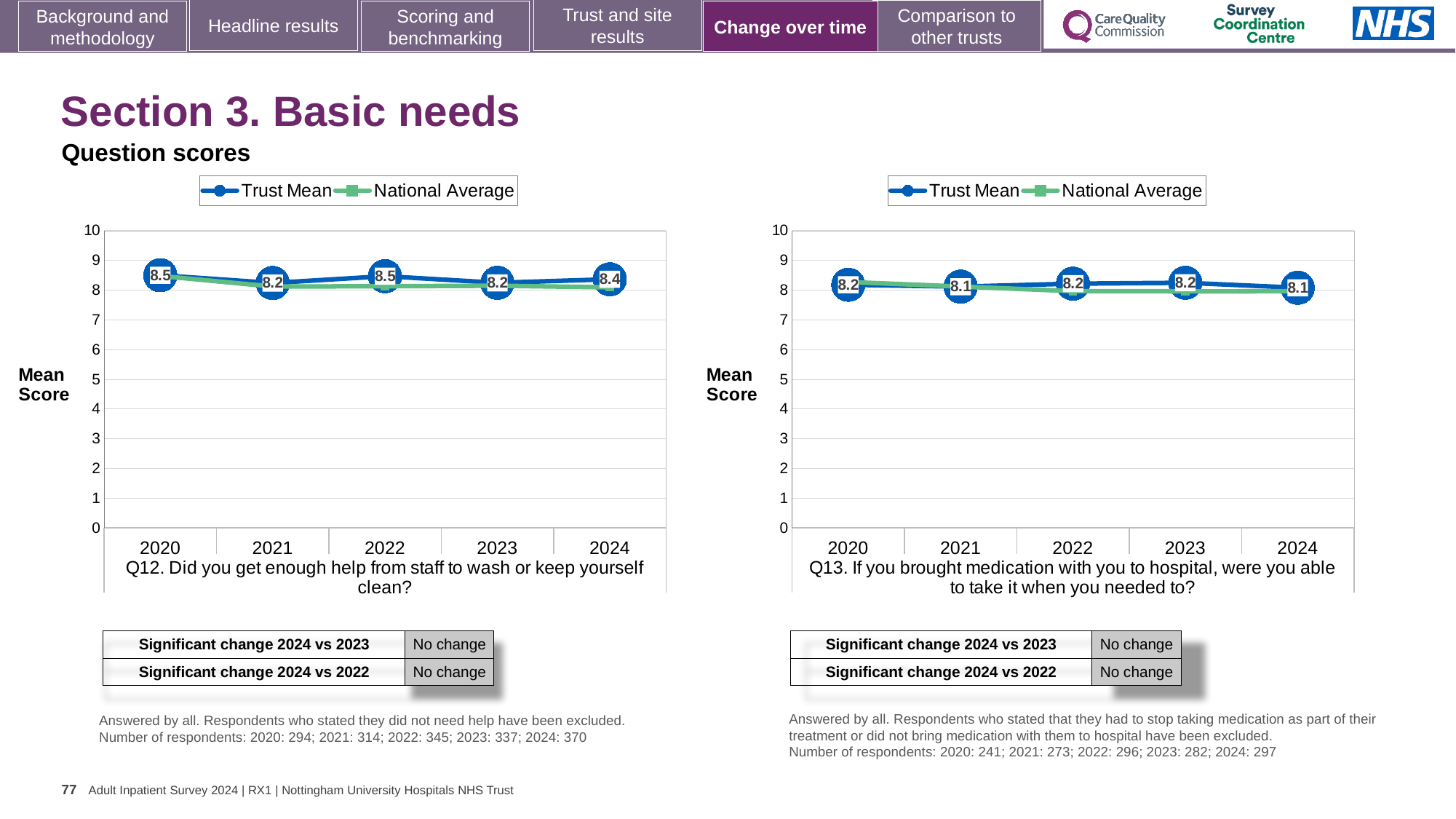
On the Q12 chart (left), what is the Trust Mean for 2021? 8.2 On the Q13 chart (right), what is the difference between the Trust Mean in 2022 and in 2024? 0.1 On the Q13 chart (right), what is the Trust Mean for 2024? 8.1 How many years are plotted on the Q13 chart (right)? 5 How many series does the legend of the Q12 chart (left) list? 2 On the Q12 chart (left), which year has the larger Trust Mean, 2022 or 2023? 2022 On the Q12 chart (left), is the National Average for 2024 greater or less than 5? greater On the Q12 chart (left), what is the Trust Mean for 2024? 8.4 What is the y-axis label on the Q12 chart (left)? Mean Score On the Q13 chart (right), what is the Trust Mean for 2020? 8.2 What type of chart is the Q13 chart (right)? Line chart On the Q12 chart (left), what is the difference between the Trust Mean in 2020 and in 2021? 0.3